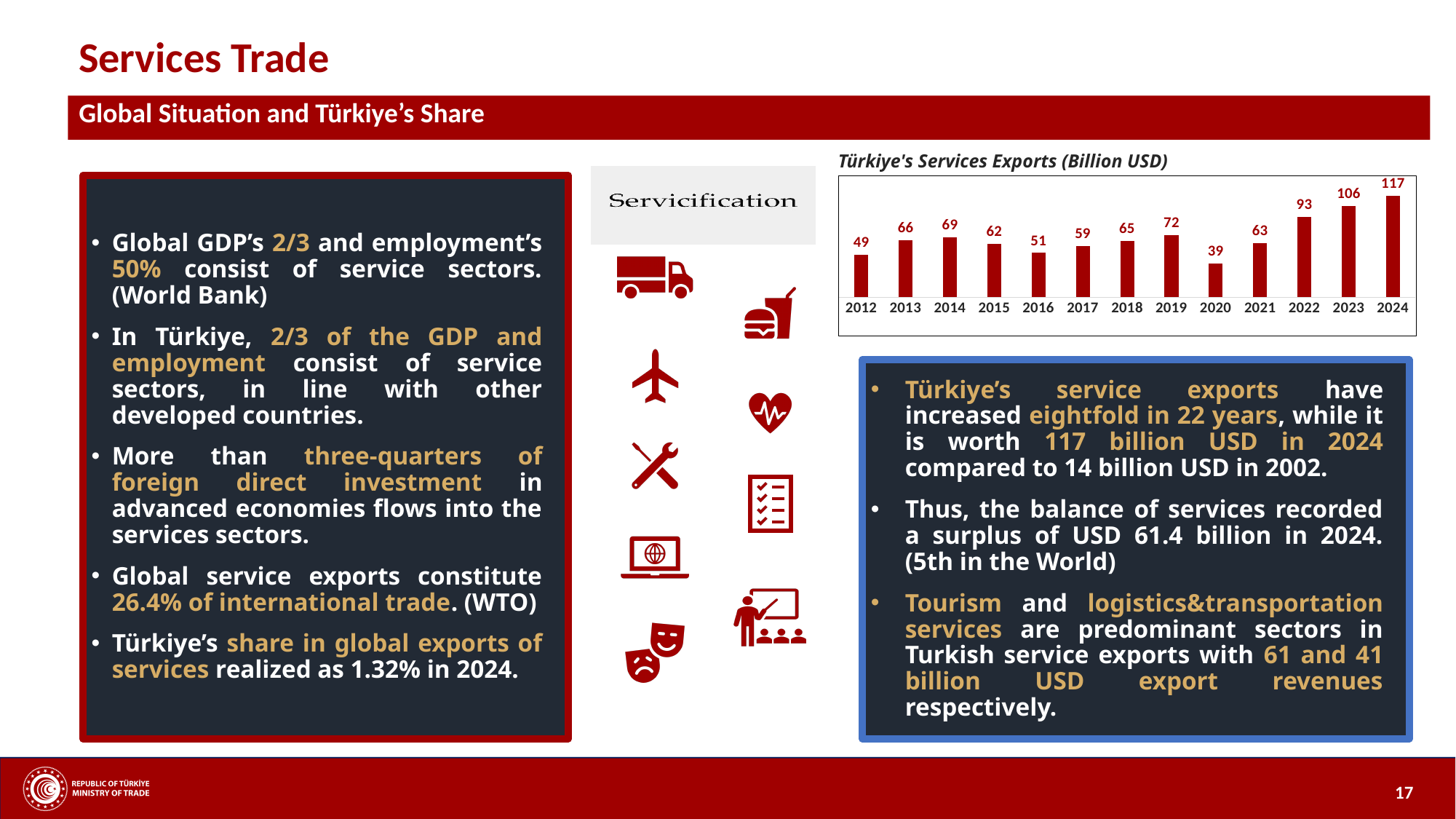
Which year has the lowest value in the Türkiye's Services Exports chart? 2020 What is the difference between the 2019 and 2020 values in the Türkiye's Services Exports chart? 33 What is the difference between the 2024 and 2023 values in the Türkiye's Services Exports chart? 11 How many years are shown in the Türkiye's Services Exports chart? 13 What is the value for 2020 in the Türkiye's Services Exports chart? 39 What is the value for 2024 in the Türkiye's Services Exports chart? 117 What is the value for 2012 in the Türkiye's Services Exports chart? 49 Which year has the highest value in the Türkiye's Services Exports chart? 2024 What kind of chart is the Türkiye's Services Exports chart? Bar chart What unit is given in the title of the Türkiye's Services Exports chart? Billion USD Which is larger in the Türkiye's Services Exports chart, the value for 2014 or the value for 2018? 2014 Do the values in the Türkiye's Services Exports chart rise or fall from 2020 to 2024? Rise